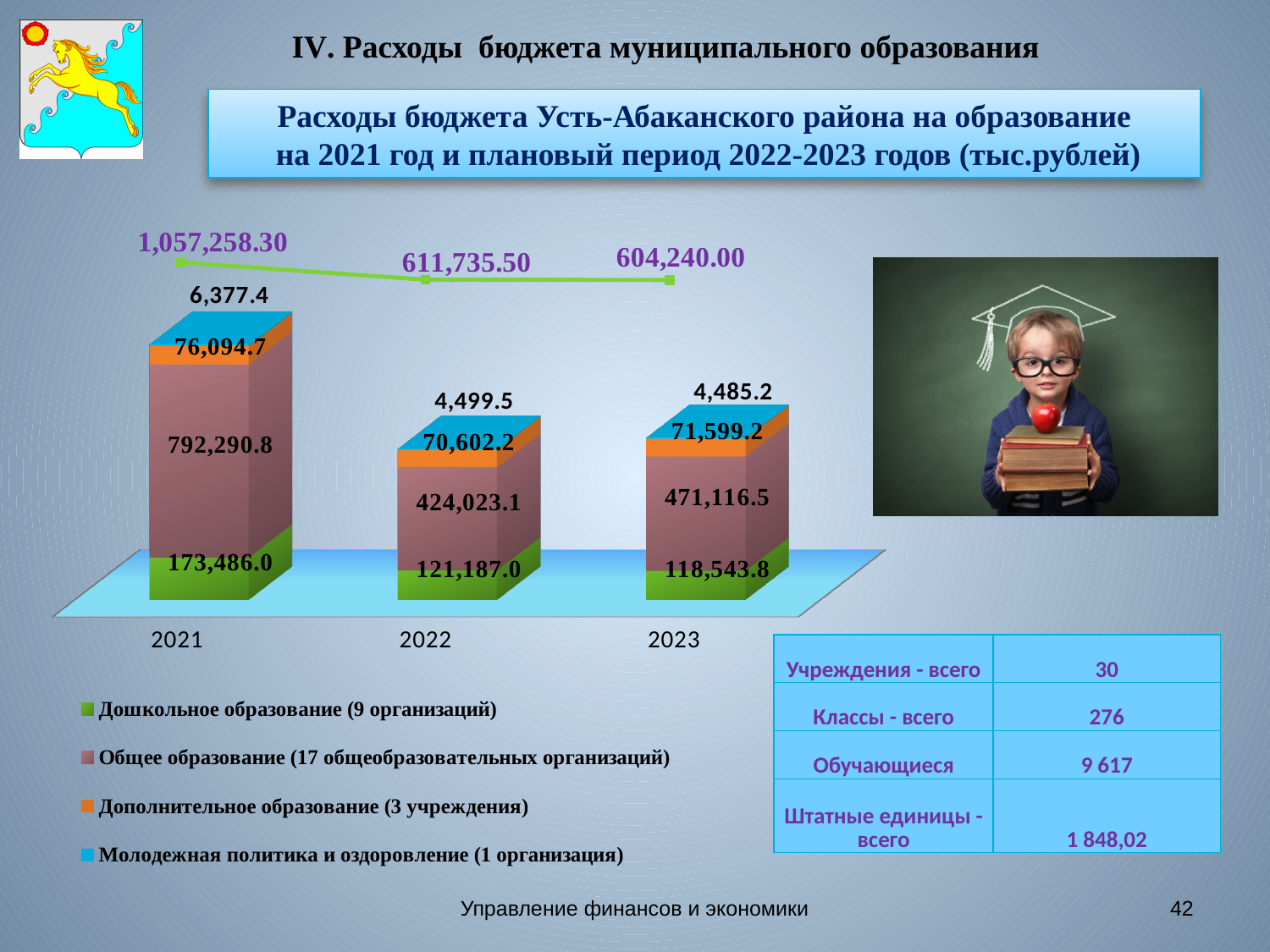
Which year has the larger value for Дополнительное образование, 2022 or 2023? 2023 How many years are shown on the x axis of the chart? 3 What is the value for Молодежная политика и оздоровление in 2023? 4,485.2 What is the value for Дошкольное образование in 2022? 121,187.0 How many series does the legend list? 4 What is the value for Общее образование in 2021? 792,290.8 In which year is the value for Общее образование the highest? 2021 In which year is the value for Дошкольное образование the lowest? 2023 What value is shown on the line above the bars for 2022? 611,735.50 By how much does Общее образование in 2023 exceed Общее образование in 2022? 47,093.4 What is the value for Дополнительное образование in 2021? 76,094.7 Do the values shown on the line above the bars rise or fall from 2021 to 2023? fall